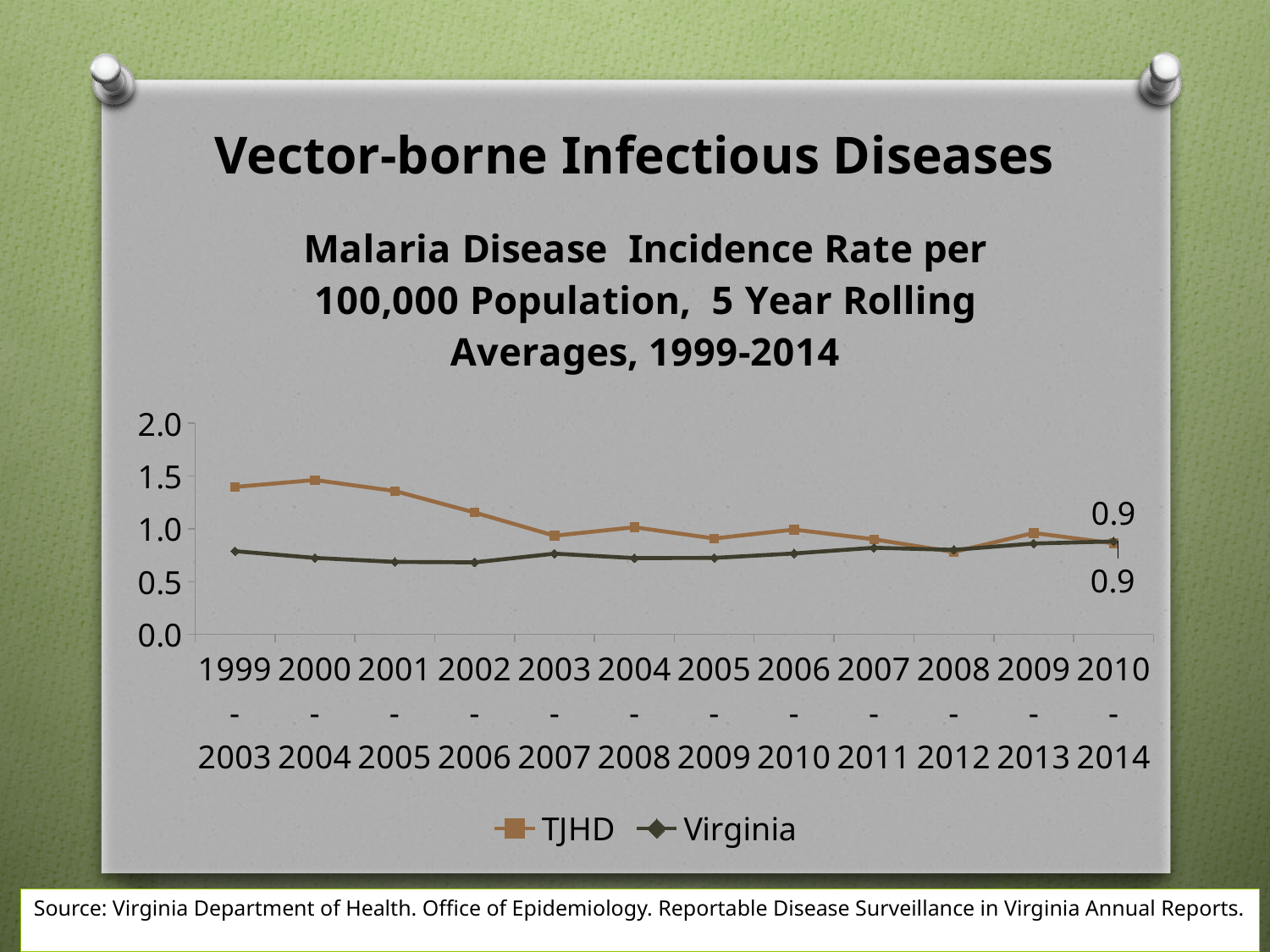
Does the TJHD series rise or fall from 1999-2003 to 2003-2007? fall Is the Virginia value for 2001-2005 greater or less than 0.5? greater How many rolling-average periods are plotted along the x axis? 12 Is the Virginia value for 1999-2003 greater or less than 1.0? less For the 1999-2003 period, which series has the larger value, TJHD or Virginia? TJHD What kind of chart is shown on the slide? line chart What is the Virginia malaria incidence rate for the 2010-2014 period? 0.9 In which period does the TJHD series reach its highest value? 2000-2004 Is the TJHD value for 1999-2003 greater or less than 1.0? greater What is the TJHD malaria incidence rate for the 2010-2014 period? 0.9 How many series does the legend list? 2 What are the two series named in the legend? TJHD and Virginia